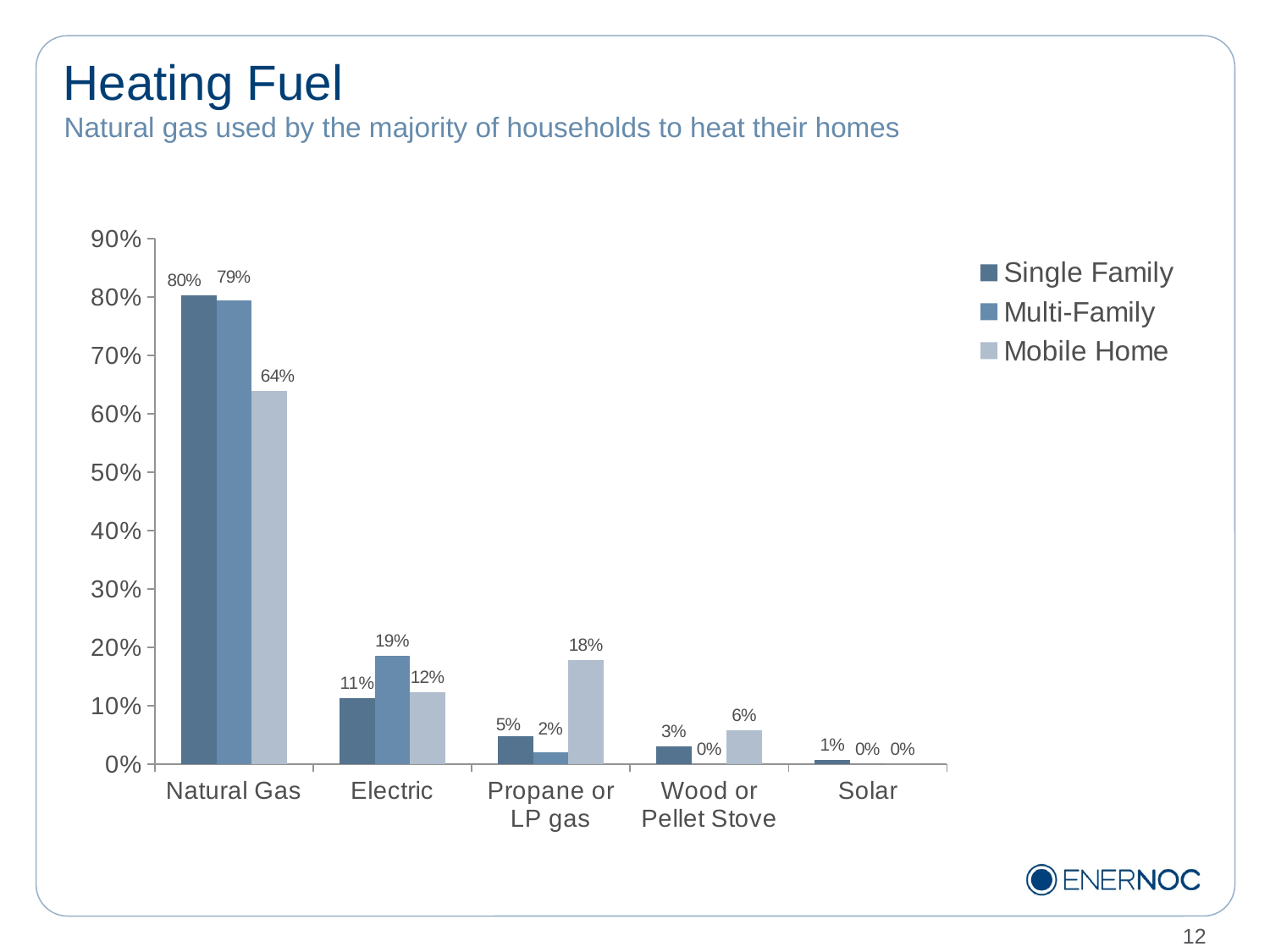
What is the difference between the Single Family and Mobile Home values for Natural Gas? 16% Which heating fuel category has the highest value for Mobile Home households? Natural Gas What kind of chart is shown on the slide? Bar chart How many series does the legend list? 3 Which is larger for Propane or LP gas: the Single Family value or the Mobile Home value? Mobile Home What percentage of Mobile Home households use Propane or LP gas? 18% What is the title of the slide containing the chart? Heating Fuel How many heating fuel categories are shown on the x axis? 5 What percentage of Single Family households use Natural Gas for heating? 80% What percentage of Multi-Family households use Electric heating? 19% Which heating fuel category has the lowest value for Single Family households? Solar Is the Multi-Family value for Natural Gas greater or less than 70%? greater